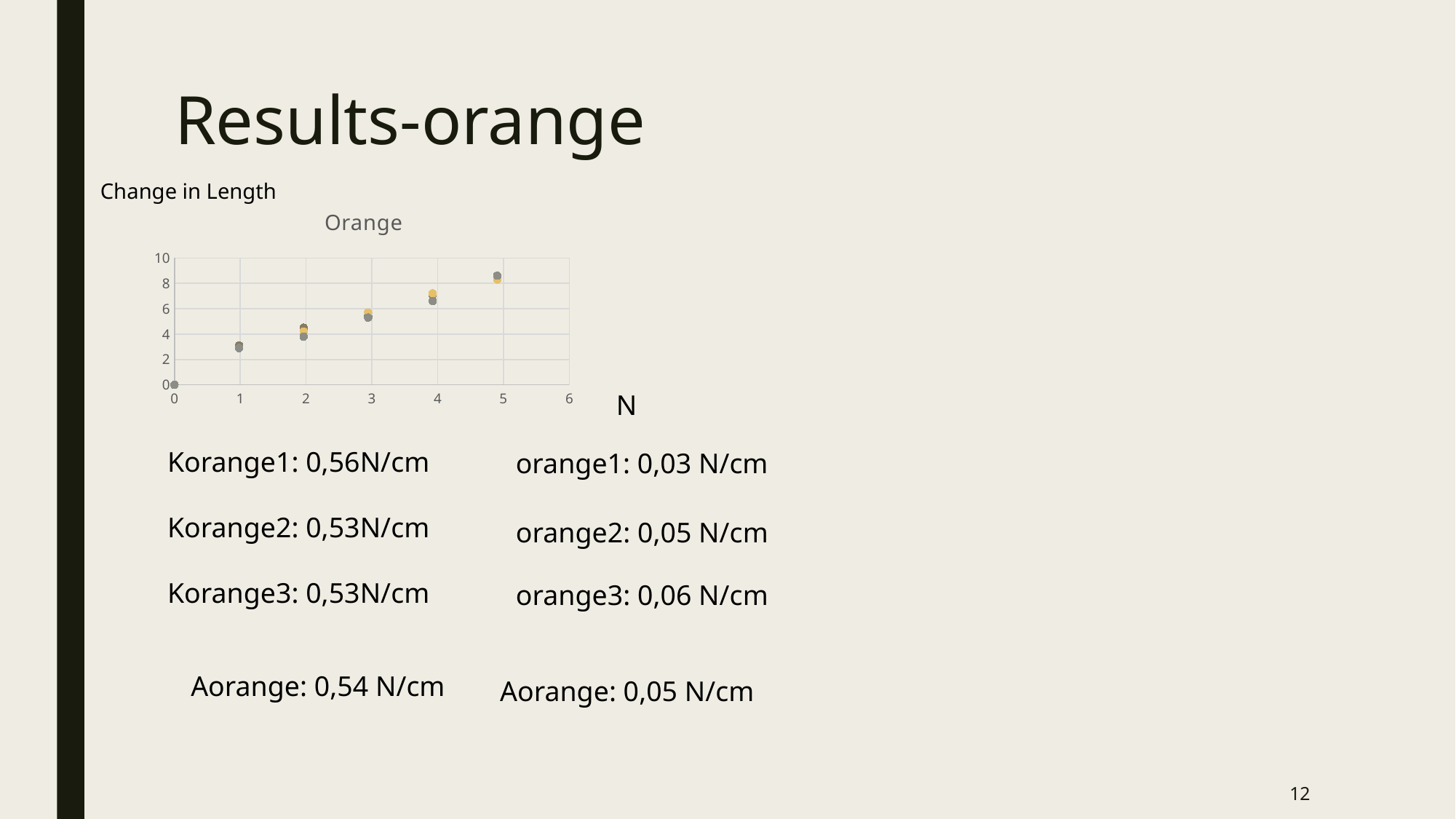
Do the plotted values rise or fall as N increases along the x axis? rise Is the value plotted at N = 1 greater or less than 4? less What label is shown for the x axis of the chart? N Is the value plotted at N = 2 greater or less than 6? less What kind of chart is shown on the slide? scatter chart What is the maximum value shown on the y axis of the chart? 10 Is the value plotted at N = 3 greater or less than 4? greater At which value of N are the plotted points highest? 5 What is the title of the chart? Orange At which value of N are the plotted points lowest? 0